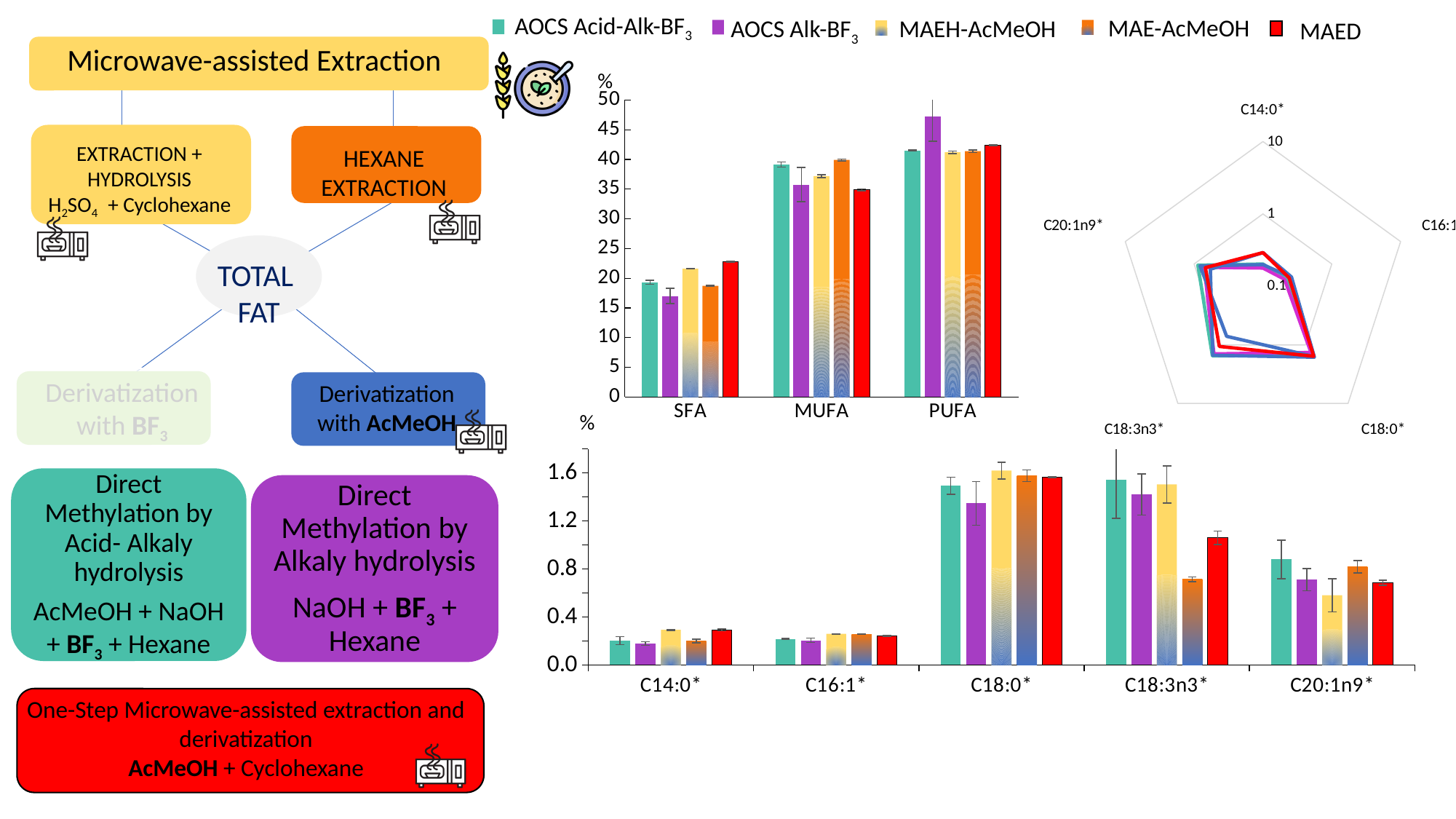
How many series does the legend at the top of the slide list? 5 In the bottom bar chart, which series has the lowest value for C18:3n3*? MAE-AcMeOH In the top bar chart, which series has the highest value for SFA? MAED In the top bar chart, is the SFA value for MAED greater or less than 20? greater What kind of chart is the pentagon-shaped chart on the right of the slide? radar chart In the bottom bar chart, for C18:3n3*, which is larger: MAED or MAE-AcMeOH? MAED How many categories are shown on the x axis of the top bar chart (SFA, MUFA, PUFA)? 3 In the top bar chart, which series has the highest value for PUFA? AOCS Alk-BF3 How many categories are shown on the x axis of the bottom bar chart (C14:0* to C20:1n9*)? 5 In the bottom bar chart, is the C18:3n3* value for MAE-AcMeOH greater or less than 0.8? less In the top bar chart, is the MUFA value for MAED greater or less than 40? less What kind of chart is the top chart with categories SFA, MUFA and PUFA? bar chart